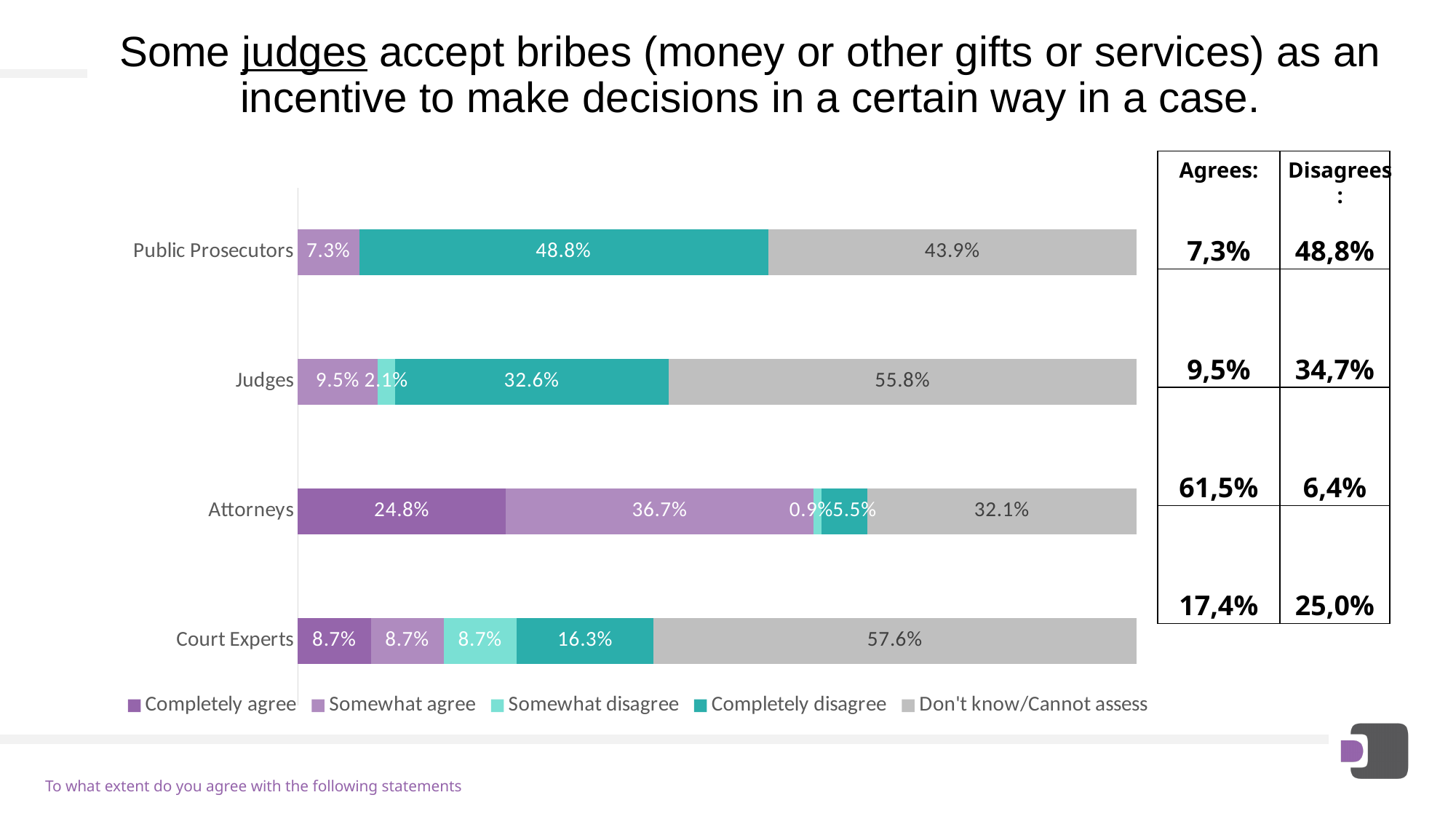
Which series is shown in grey in the legend? Don't know/Cannot assess What is the 'Completely disagree' value for Public Prosecutors? 48.8% Which is larger: the 'Somewhat agree' value for Attorneys or for Court Experts? Attorneys Which group has the highest 'Don't know/Cannot assess' value? Court Experts What is the 'Completely agree' value for Attorneys? 24.8% Which group has the lowest 'Completely disagree' value? Attorneys What is the 'Completely disagree' value for Court Experts? 16.3% How many series does the legend list? 5 How many respondent groups (categories) are shown on the chart? 4 What is the difference between the 'Don't know/Cannot assess' values for Judges and Public Prosecutors? 11.9% What is the 'Don't know/Cannot assess' value for Judges? 55.8% What kind of chart is shown on the slide? Stacked bar chart